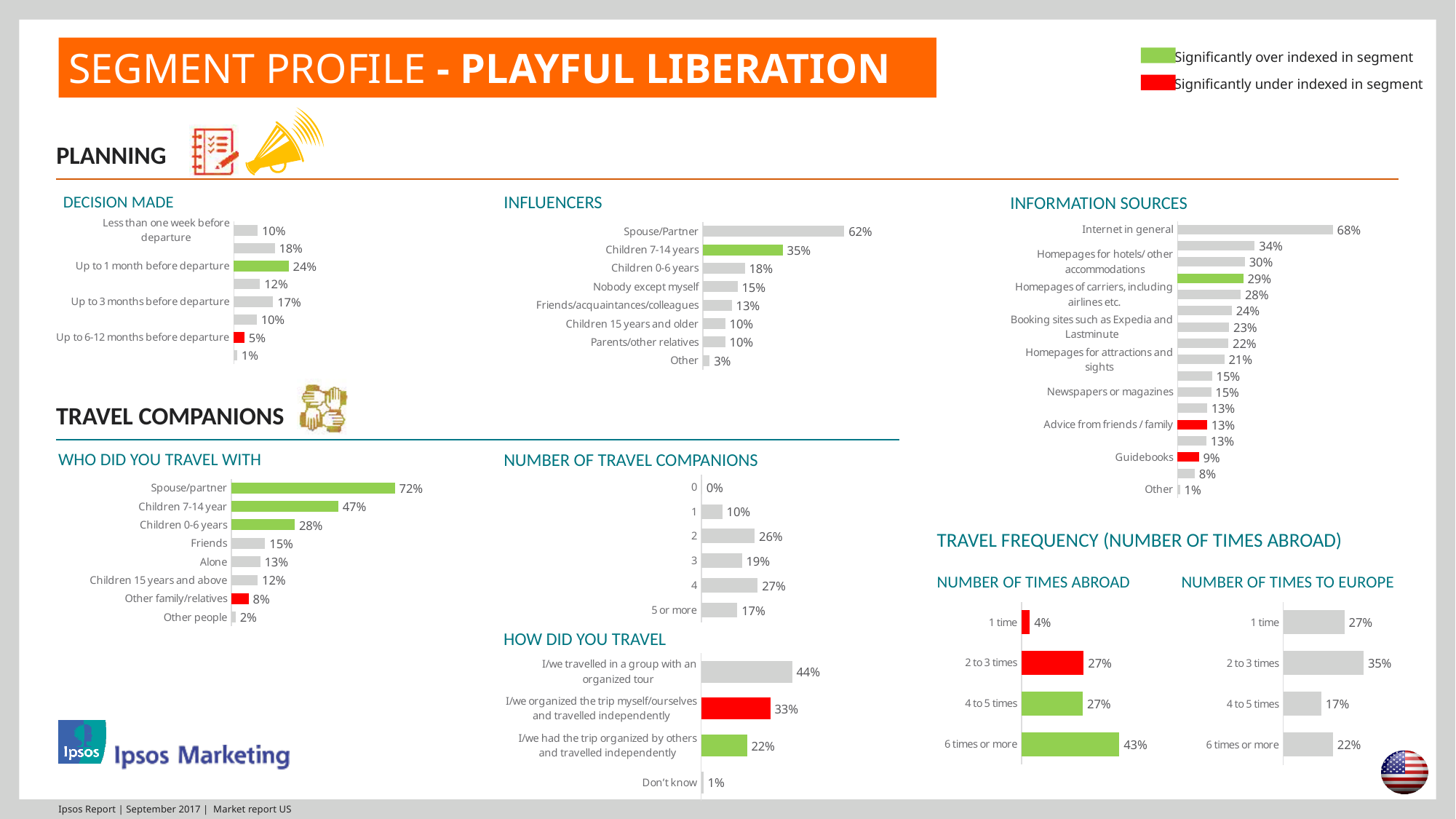
In the NUMBER OF TIMES ABROAD chart, which category has the highest value? 6 times or more In the NUMBER OF TRAVEL COMPANIONS chart, what is the value for 4? 27% In the NUMBER OF TRAVEL COMPANIONS chart, which category has the lowest value? 0 In the WHO DID YOU TRAVEL WITH chart, which category has the highest value? Spouse/partner In the INFORMATION SOURCES chart, what is the value for Internet in general? 68% In the INFLUENCERS chart, what is the value for Spouse/Partner? 62% In the WHO DID YOU TRAVEL WITH chart, what is the difference between Spouse/partner and Children 7-14 year? 25% In the HOW DID YOU TRAVEL chart, what is the value for 'I/we organized the trip myself/ourselves and travelled independently'? 33% How many categories are shown in the NUMBER OF TIMES ABROAD chart? 4 In the NUMBER OF TIMES TO EUROPE chart, is the value for 1 time or 2 to 3 times larger? 2 to 3 times What type of chart is the INFLUENCERS chart? Bar chart In the INFORMATION SOURCES chart, what is the value for Guidebooks? 9%